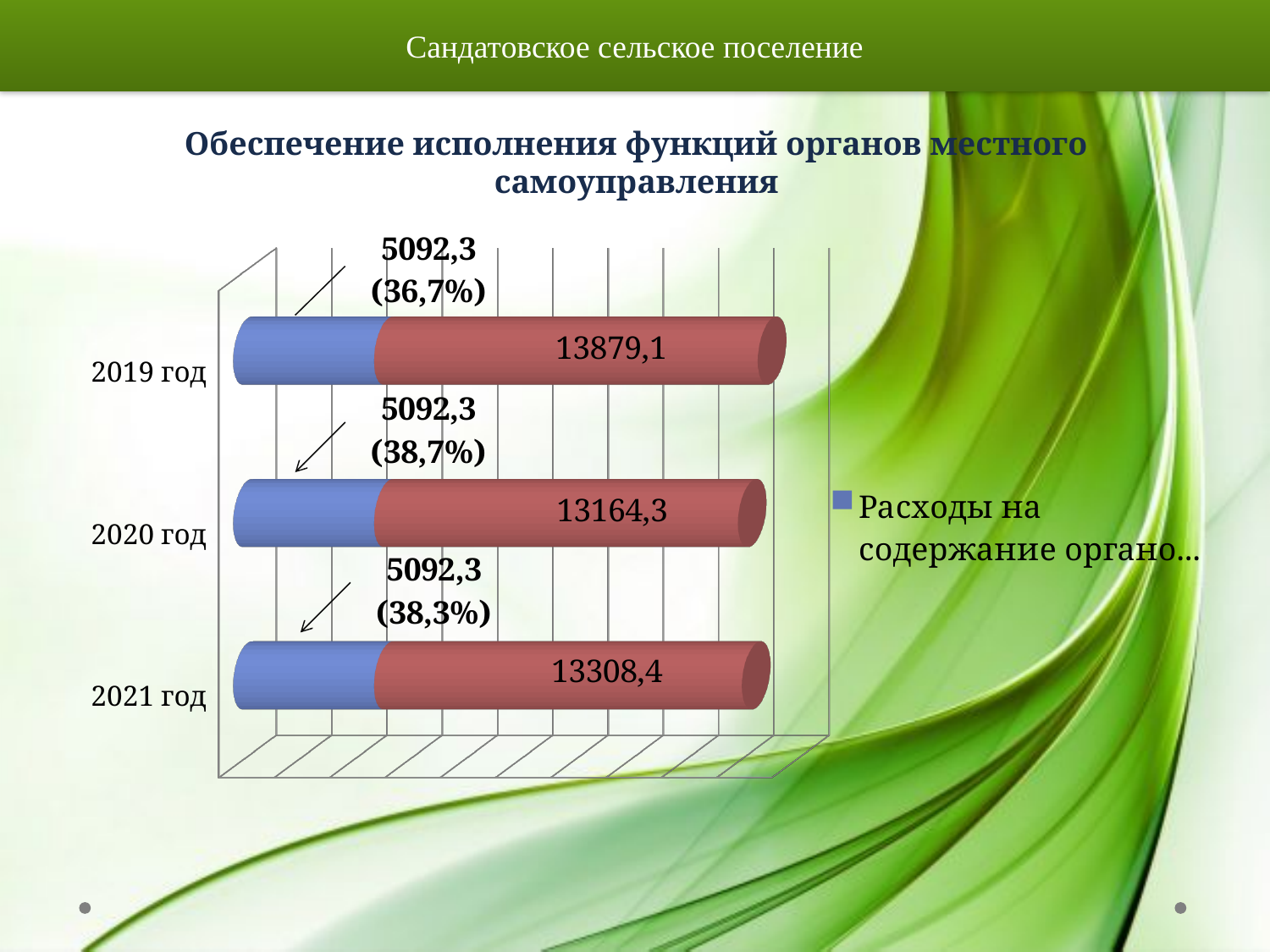
What is the difference between the values printed on the red bars for 2019 год and 2020 год? 714,8 What value is labelled for the blue segment in 2021 год? 5092,3 What value is printed on the red bar for 2021 год? 13308,4 Which year has the lowest value printed on its red bar? 2020 год Which year has the highest value printed on its red bar? 2019 год Which is larger: the value printed on the red bar for 2021 год or for 2020 год? 2021 год What kind of chart is shown on the slide? bar chart What value is printed on the red bar for 2020 год? 13164,3 How many years (categories) are shown on the chart? 3 What value is printed on the red bar for 2019 год? 13879,1 What is the title of the chart? Обеспечение исполнения функций органов местного самоуправления What percentage is shown in parentheses for 2020 год? 38,7%